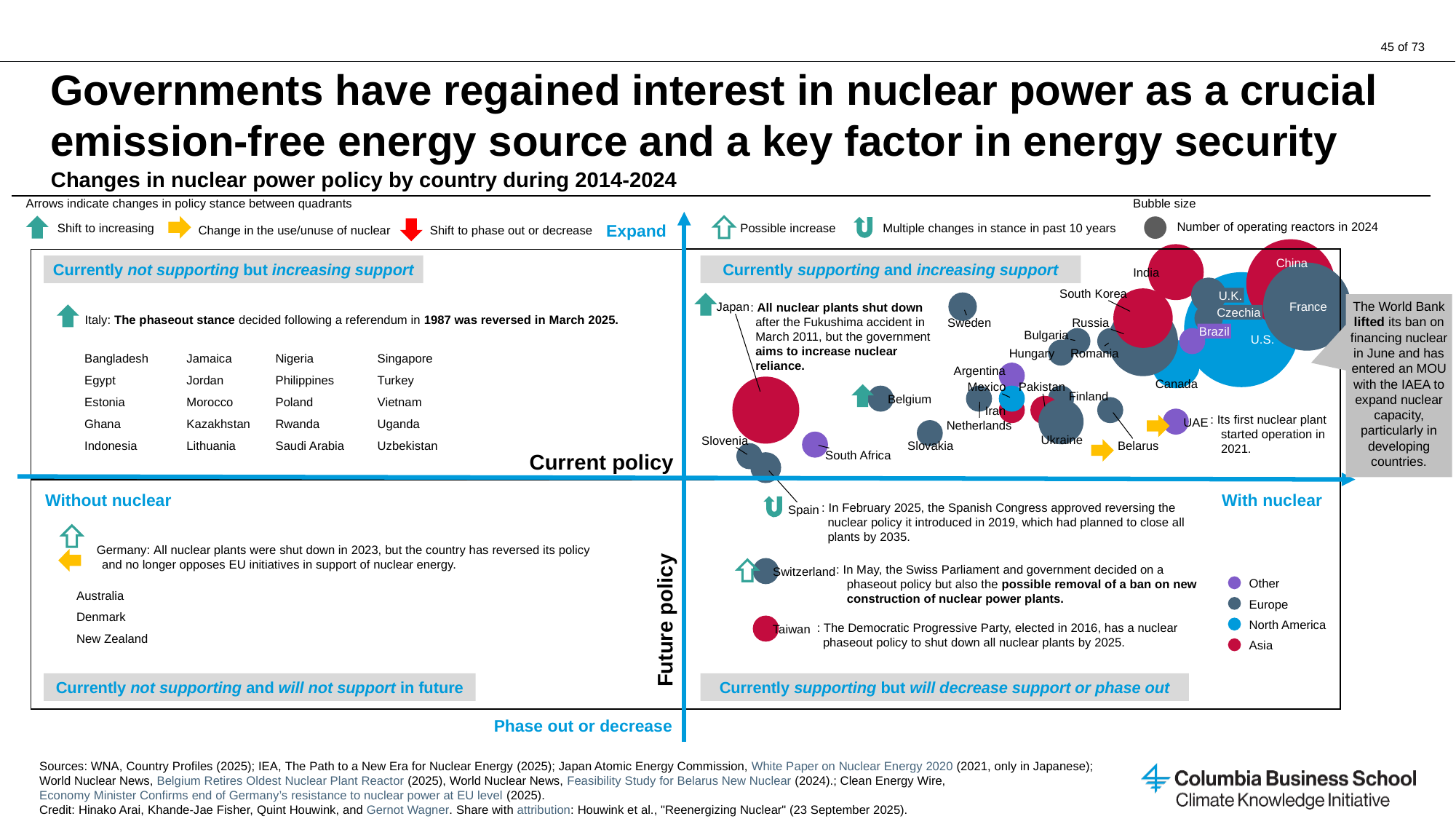
How many countries are listed in the 'Currently not supporting and will not support in future' quadrant? 3 In which quadrant is Germany placed? Currently not supporting and will not support in future Which has the larger bubble, France or Belgium? France What kind of chart is shown on the slide? Bubble chart In which quadrant is Taiwan placed? Currently supporting but will decrease support or phase out Which region does the legend assign to the red bubbles? Asia Which has the larger bubble, China or South Africa? China What does the bubble size represent? Number of operating reactors in 2024 Which has the larger bubble, the U.S. or Slovenia? U.S. How many regions does the bubble colour legend list? 4 Which country has the largest bubble on the chart? U.S.